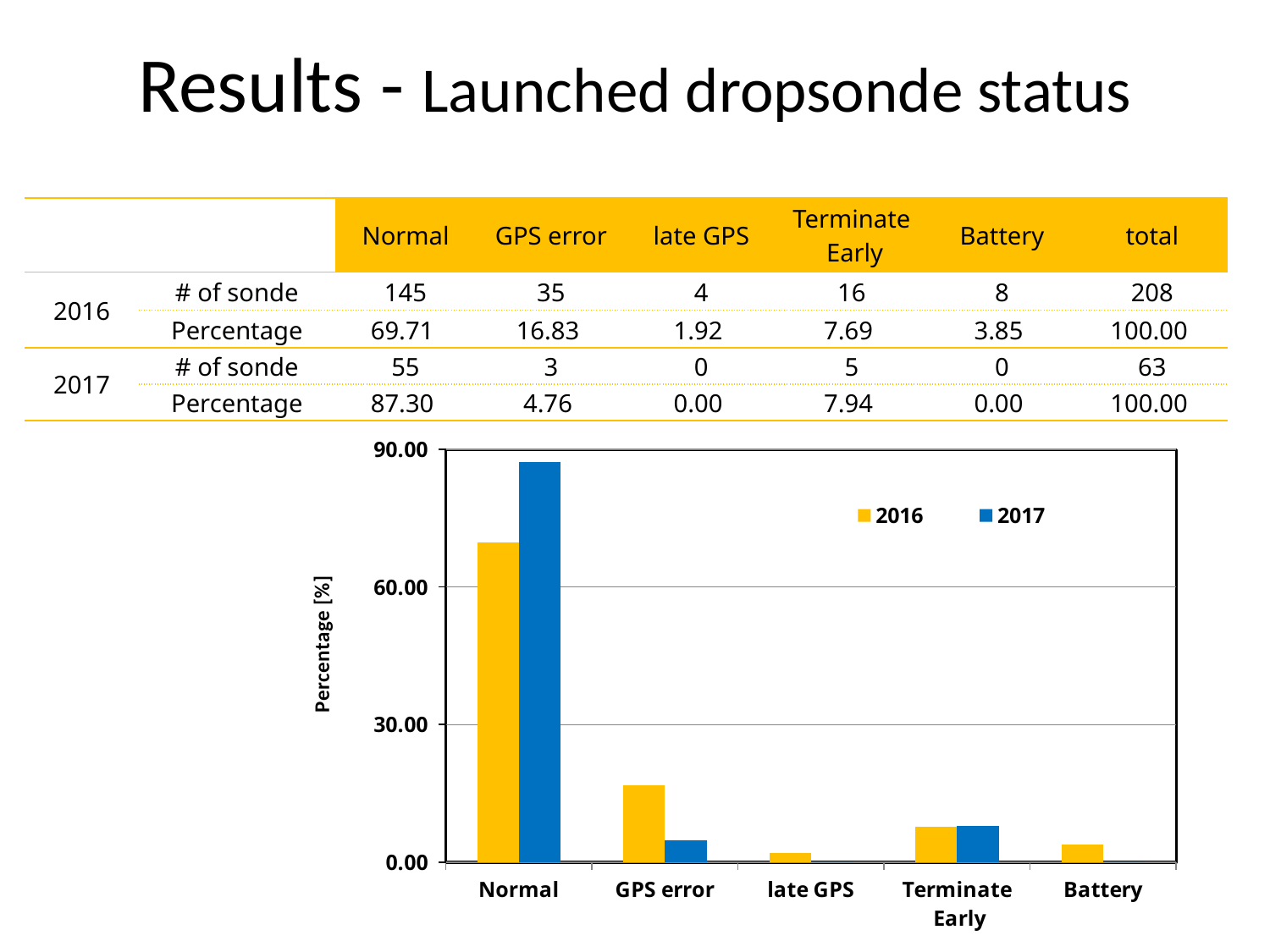
According to the table on the slide, what is the 2017 percentage for Terminate Early? 7.94 For the Normal category, which series has the larger value, 2016 or 2017? 2017 What kind of chart is shown on the slide? bar chart Is the 2016 value for GPS error greater or less than 30.00? less How many categories are shown on the x axis of the chart? 5 How many series does the chart legend list? 2 For the GPS error category, which series has the larger value, 2016 or 2017? 2016 What is the label of the y axis of the chart? Percentage [%] Which category has the highest percentage for 2017 in the chart? Normal Which category has the highest percentage for 2016 in the chart? Normal According to the table on the slide, what is the 2016 percentage for Normal? 69.71 Is the 2017 value for Normal greater or less than 60.00? greater